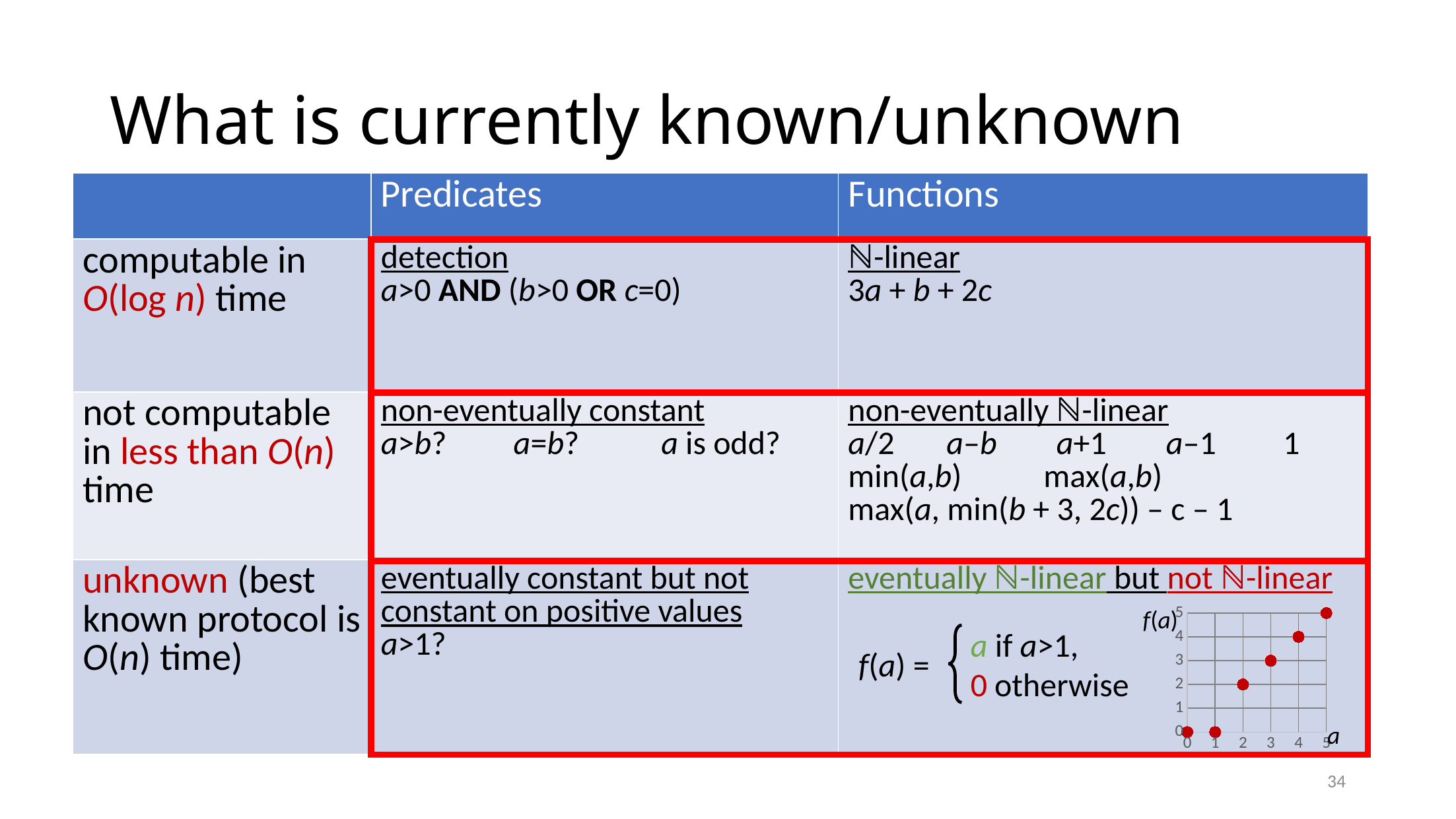
In the scatter chart of f(a), do the plotted values rise or fall as a increases from 2 to 5? rise What kind of chart is shown in the bottom-right cell of the table? scatter chart In the scatter chart of f(a), what is the value of f(a) at a = 1? 0 In the scatter chart of f(a), what colour are the plotted points? red In the scatter chart of f(a), how many points are plotted? 6 In the scatter chart of f(a), what is the value of f(a) at a = 0? 0 In the scatter chart of f(a), what is the value of f(a) at a = 3? 3 In the scatter chart of f(a), what is the value of f(a) at a = 5? 5 In the scatter chart of f(a), what is the label on the horizontal axis? a In the scatter chart of f(a), at which value of a is f(a) highest? 5 In the scatter chart of f(a), what is the difference between f(a) at a = 4 and f(a) at a = 2? 2 In the scatter chart of f(a), which is larger: f(a) at a = 2 or f(a) at a = 1? f(a) at a = 2